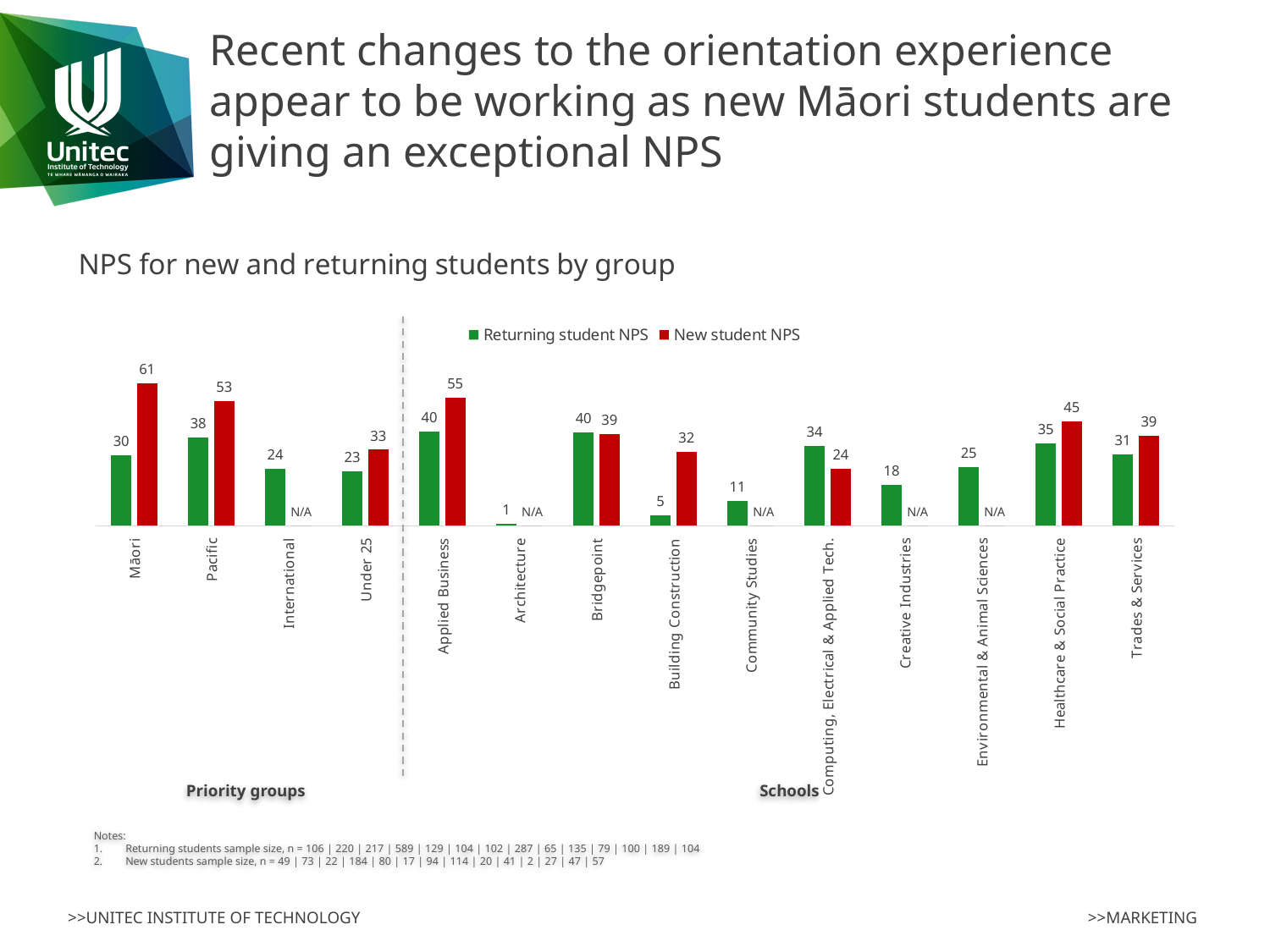
Which group has the lowest Returning student NPS? Architecture How many series does the chart legend list? 2 Which group has the highest New student NPS? Māori What is the difference between the New student NPS and the Returning student NPS for Building Construction? 27 What is the difference between the New student NPS and the Returning student NPS for Māori? 31 What is the New student NPS for Healthcare & Social Practice? 45 What is shown for the New student NPS for International? N/A How many groups are shown on the x axis of the chart? 14 For Bridgepoint, which is larger: the Returning student NPS or the New student NPS? Returning student NPS What is the Returning student NPS for Pacific? 38 What is the New student NPS for Māori? 61 What kind of chart is shown on the slide? Bar chart